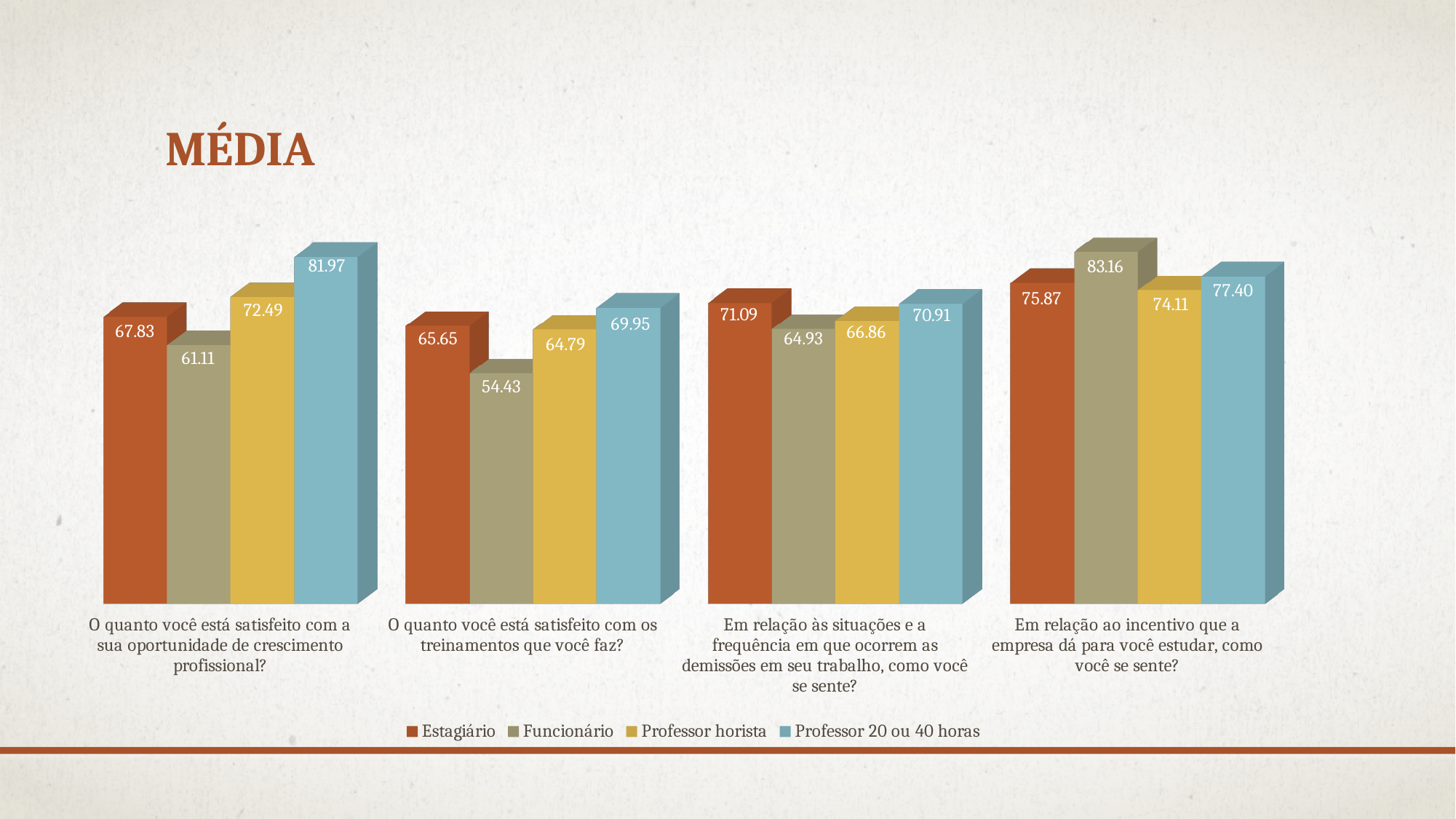
For the question about the incentive the company gives you to study, which is larger: Estagiário or Professor horista? Estagiário What is the value for Estagiário for the question about situations and frequency of dismissals at work? 71.09 Which series has the lowest value for the question about satisfaction with opportunity for professional growth? Funcionário What kind of chart is shown on the slide? Bar chart What is the difference between Funcionário and Professor horista for the question about the incentive the company gives you to study? 9.05 What is the value for Funcionário for the question about satisfaction with the training you do? 54.43 What is the difference between Professor 20 ou 40 horas and Funcionário for the question about satisfaction with opportunity for professional growth? 20.86 Which series has the highest value for the question about the incentive the company gives you to study? Funcionário How many question categories are shown on the x axis? 4 What is the title of the chart? MÉDIA What is the value for Professor 20 ou 40 horas for the question about satisfaction with opportunity for professional growth? 81.97 How many series does the legend list? 4